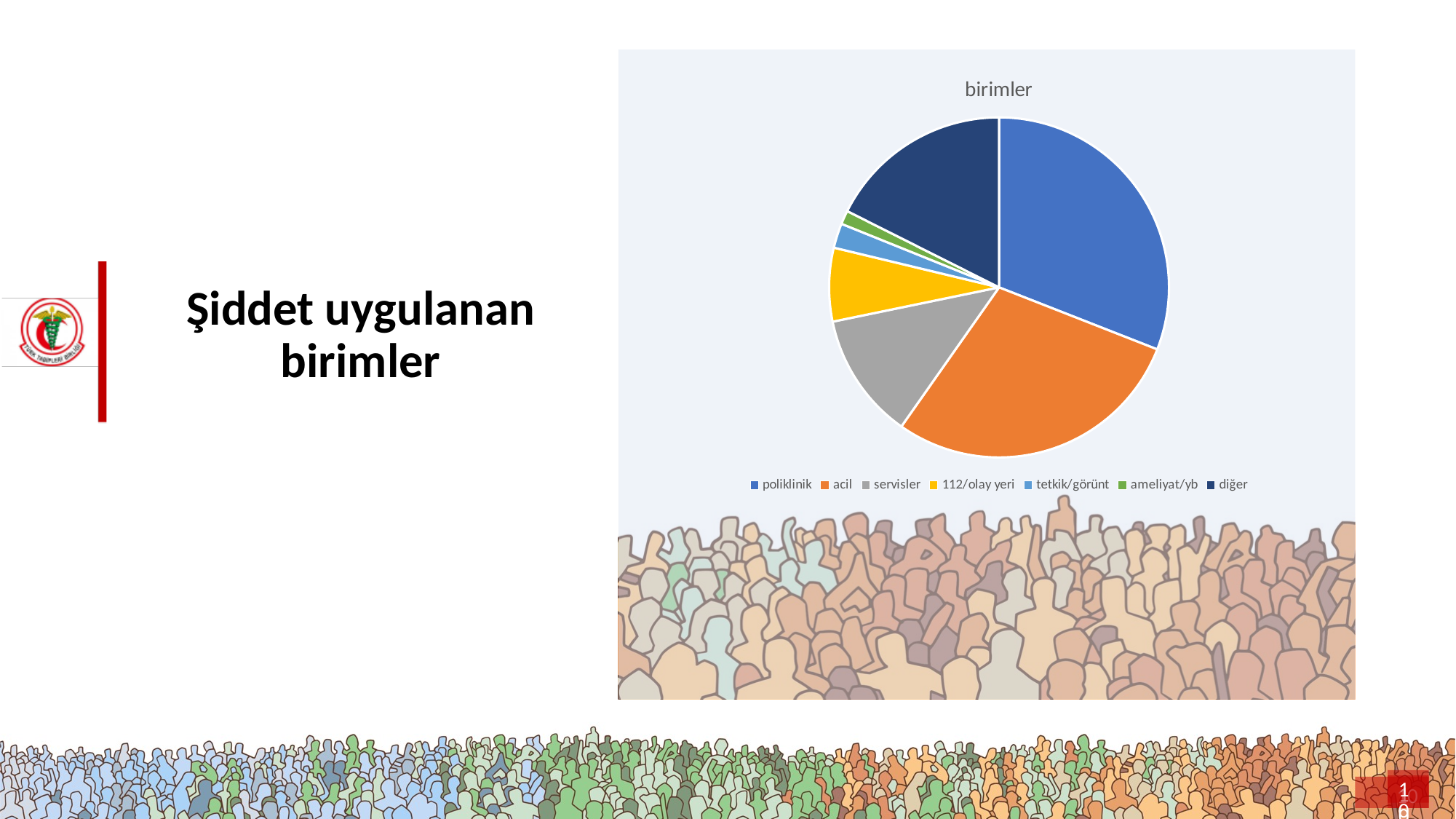
How many categories (slices) does the pie chart have? 7 Which slice is larger, tetkik/görünt or ameliyat/yb? tetkik/görünt Which slice is larger, acil or servisler? acil Which slice is larger, poliklinik or diğer? poliklinik What colour is the acil slice in the pie chart? orange What is the title of the chart? birimler What kind of chart is shown on the slide? pie chart How many entries does the chart legend list? 7 Which category has the smallest slice in the pie chart? ameliyat/yb